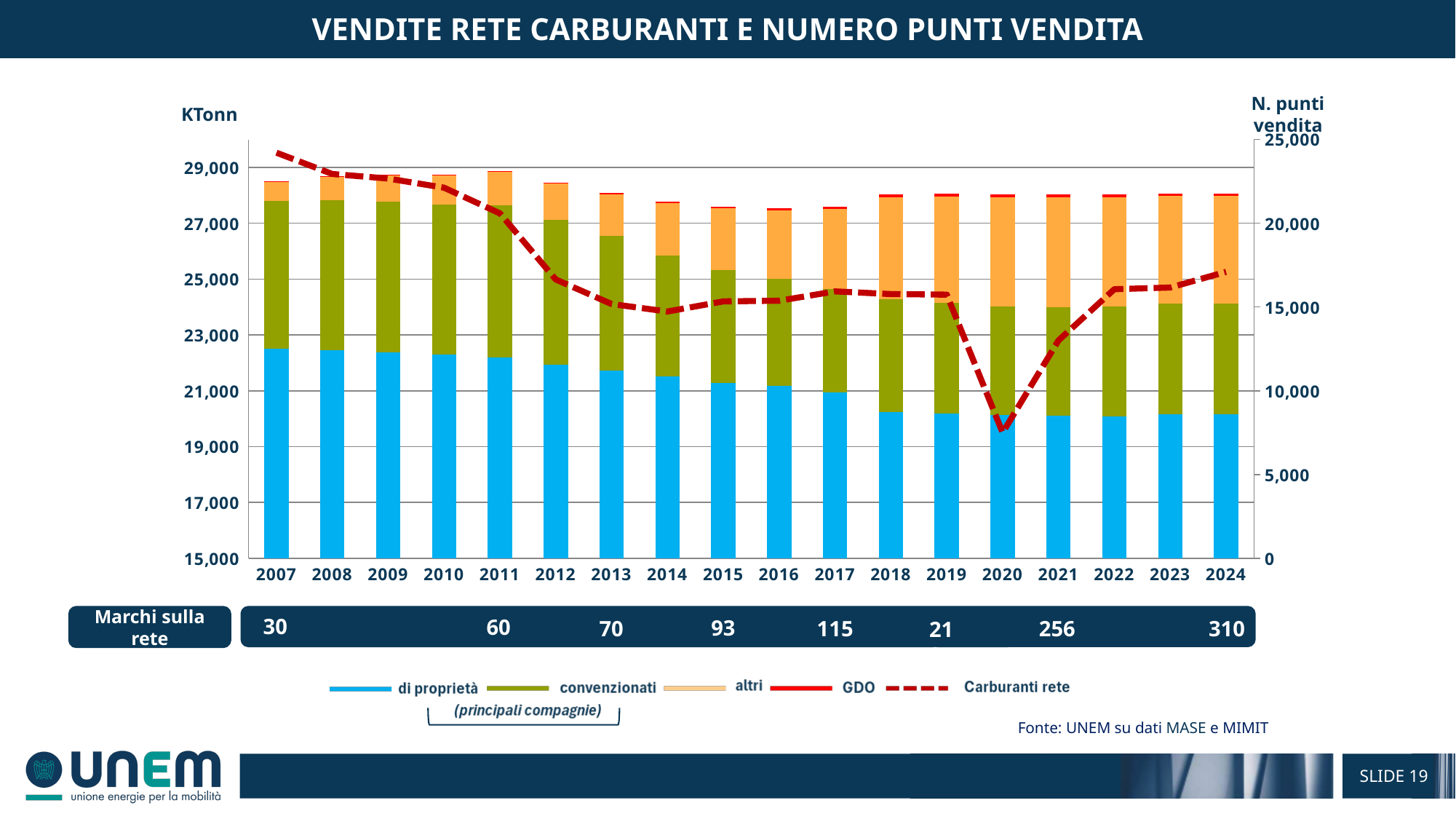
How many series does the chart legend list? 5 Does the Carburanti rete line rise or fall between 2007 and 2014? fall In which year is the Carburanti rete line at its lowest? 2020 What is the Marchi sulla rete value shown for 2024? 310 Which year has the larger di proprietà value, 2007 or 2020? 2007 How many years are shown on the x axis of the chart? 18 Is the Carburanti rete value for 2007 greater or less than 20,000? greater In which year is the Carburanti rete line at its highest? 2007 What is the unit shown on the left axis of the chart? KTonn Is the di proprietà value for 2024 greater or less than 21,000 KTonn? less What kind of chart is shown on the slide? A combination chart with stacked bars and a line Is the Carburanti rete value for 2020 greater or less than 10,000? greater